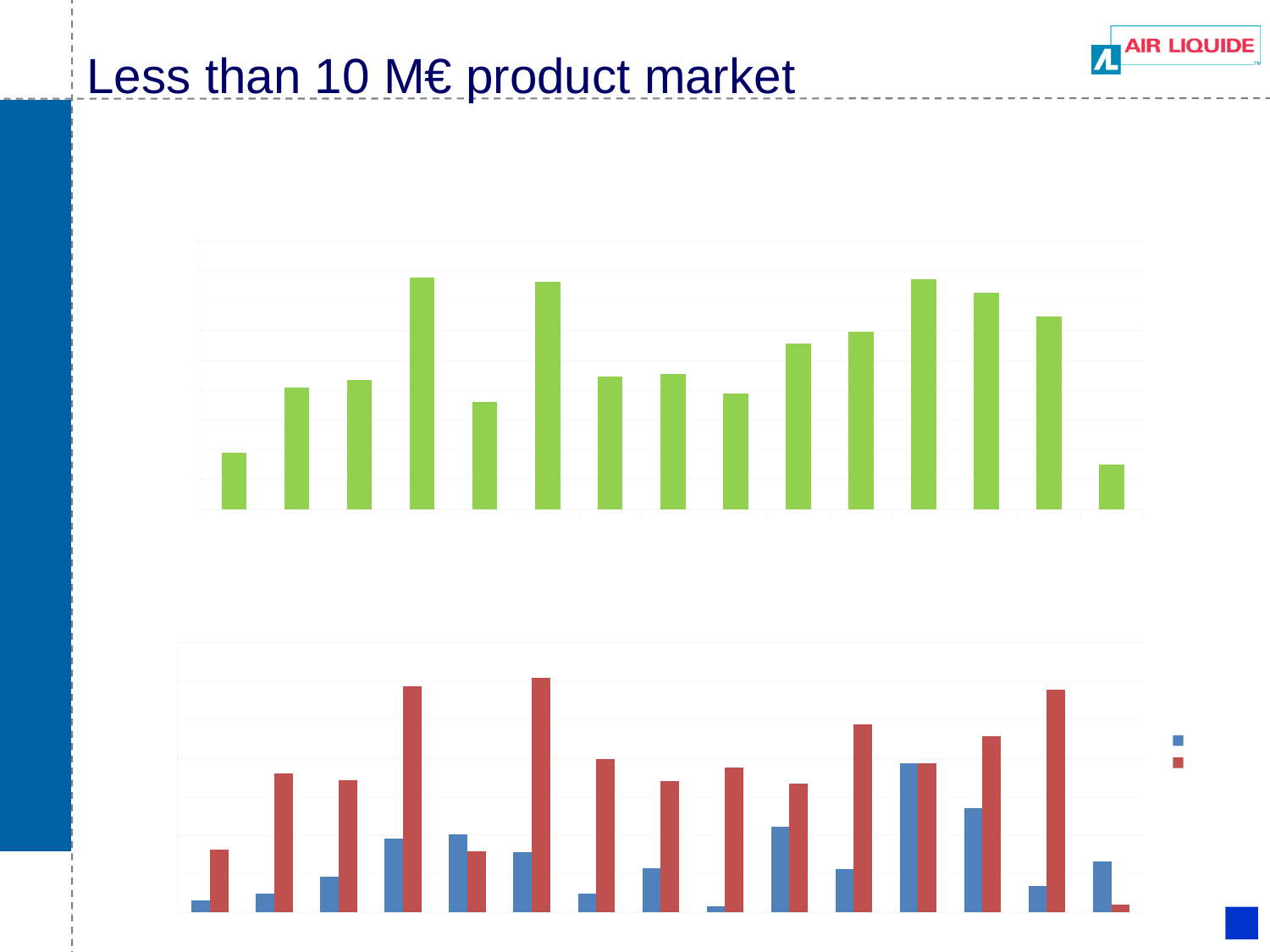
What kind of chart is the top chart on the slide? bar chart How many series does the legend of the bottom chart list? 2 How many bars are plotted in the top chart? 15 What two colours are used for the series in the bottom chart? blue and red How many categories (pairs of bars) are plotted in the bottom chart? 15 How many series are plotted in the top chart? 1 In the bottom chart, which series has the tallest bar overall, the blue series or the red series? red What colour are the bars in the top chart? green What kind of chart is the bottom chart on the slide? bar chart In the bottom chart, is the tallest blue bar taller or shorter than the tallest red bar? shorter